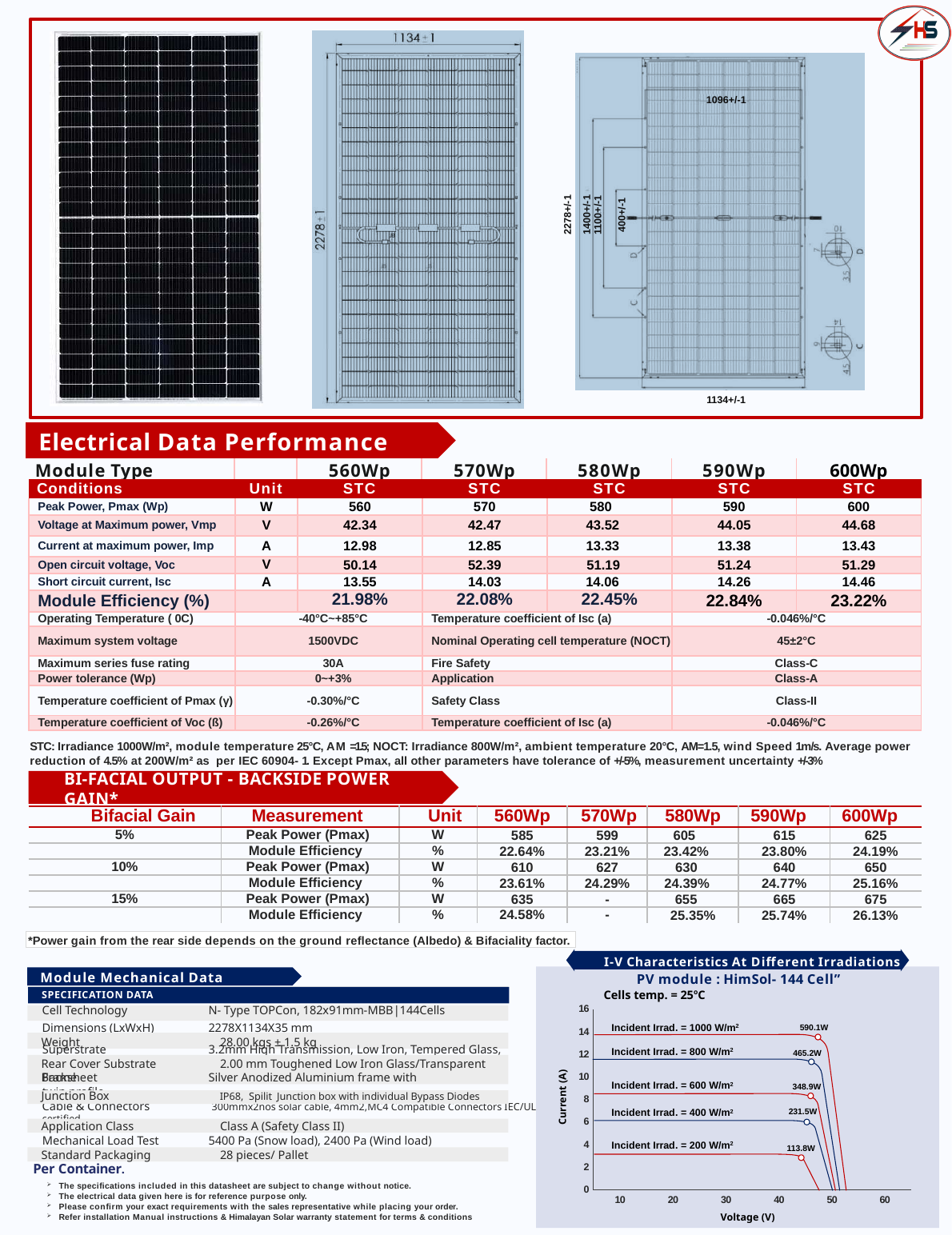
On the I-V Characteristics chart, does the current on each curve rise or fall as voltage increases toward 50 V? fall On the I-V Characteristics chart, what power value is labelled on the curve for Incident Irrad. = 200 W/m²? 113.8W On the I-V Characteristics chart, which irradiance curve has the highest labelled power? Incident Irrad. = 1000 W/m² On the I-V Characteristics chart, how many irradiance curves are plotted? 5 What is the x-axis label of the I-V Characteristics chart? Voltage (V) On the I-V Characteristics chart, what is the difference between the labelled power at 1000 W/m² and at 200 W/m²? 476.3W On the I-V Characteristics chart, what power value is labelled on the curve for Incident Irrad. = 600 W/m²? 348.9W On the I-V Characteristics chart, is the current on the flat part of the 200 W/m² curve greater or less than 4 A? less On the I-V Characteristics chart, which irradiance curve has the lowest labelled power? Incident Irrad. = 200 W/m² On the I-V Characteristics chart, which has the larger labelled power: the 800 W/m² curve or the 600 W/m² curve? 800 W/m² On the I-V Characteristics chart, what power value is labelled on the curve for Incident Irrad. = 1000 W/m²? 590.1W What type of chart is the I-V Characteristics At Different Irradiations chart? line chart